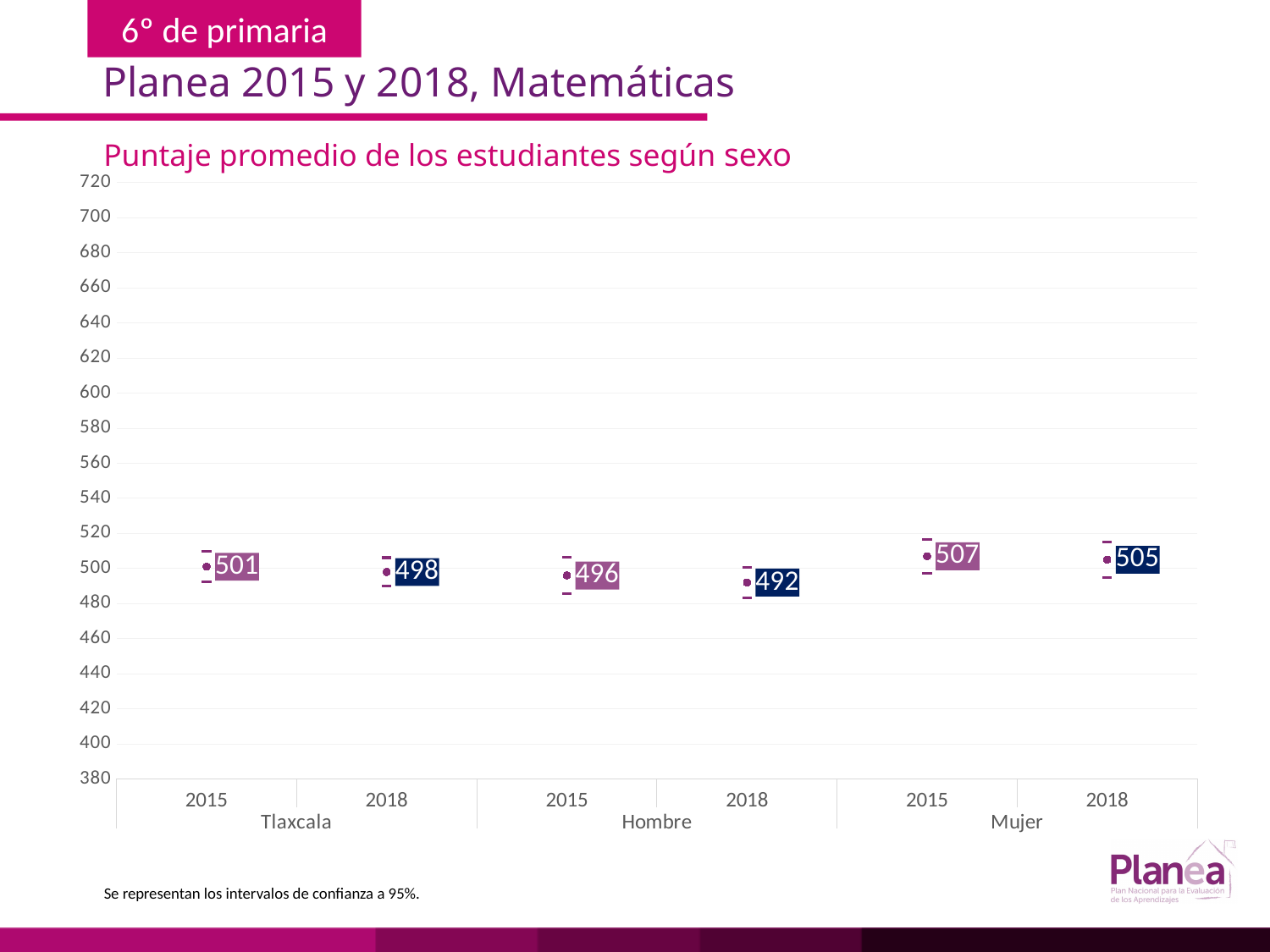
What is the title of the chart? Puntaje promedio de los estudiantes según sexo Which is larger, the Mujer score in 2018 or the Hombre score in 2018? Mujer 2018 What is the average score for Tlaxcala in 2018? 498 Did the Hombre average score rise or fall from 2015 to 2018? fall Which group and year has the lowest average score? Hombre 2018 What is the difference between the Mujer score in 2015 and the Hombre score in 2015? 11 How many data points are plotted on the chart? 6 Which group and year has the highest average score? Mujer 2015 What is the average score for Mujer in 2015? 507 By how much did the Tlaxcala average score change from 2015 to 2018? 3 What is the average score for Hombre in 2018? 492 What is the average score for Tlaxcala in 2015? 501